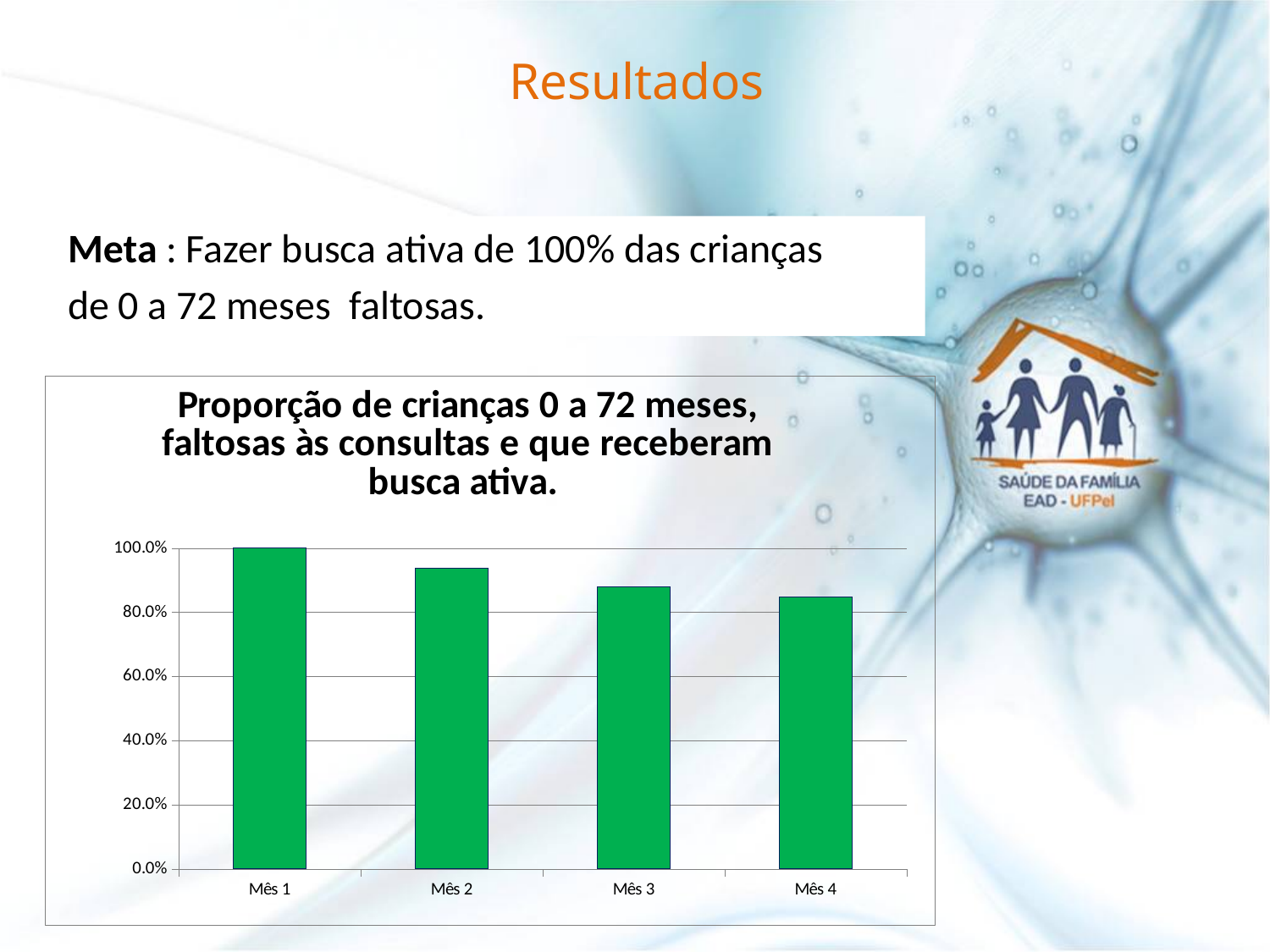
What is the value for Mês 1? 100.0% What is the title of the chart? Proporção de crianças 0 a 72 meses, faltosas às consultas e que receberam busca ativa. Which is larger, the value for Mês 2 or the value for Mês 3? Mês 2 Is the value for Mês 4 greater or less than 80.0%? greater What type of chart is shown on the slide? bar chart Which month has the highest value? Mês 1 Is the value for Mês 2 greater or less than 80.0%? greater Which month has the lowest value? Mês 4 Do the values rise or fall from Mês 1 to Mês 4? fall Is the value for Mês 3 greater or less than 100.0%? less How many categories (months) are plotted in the chart? 4 What colour are the bars in the chart? green